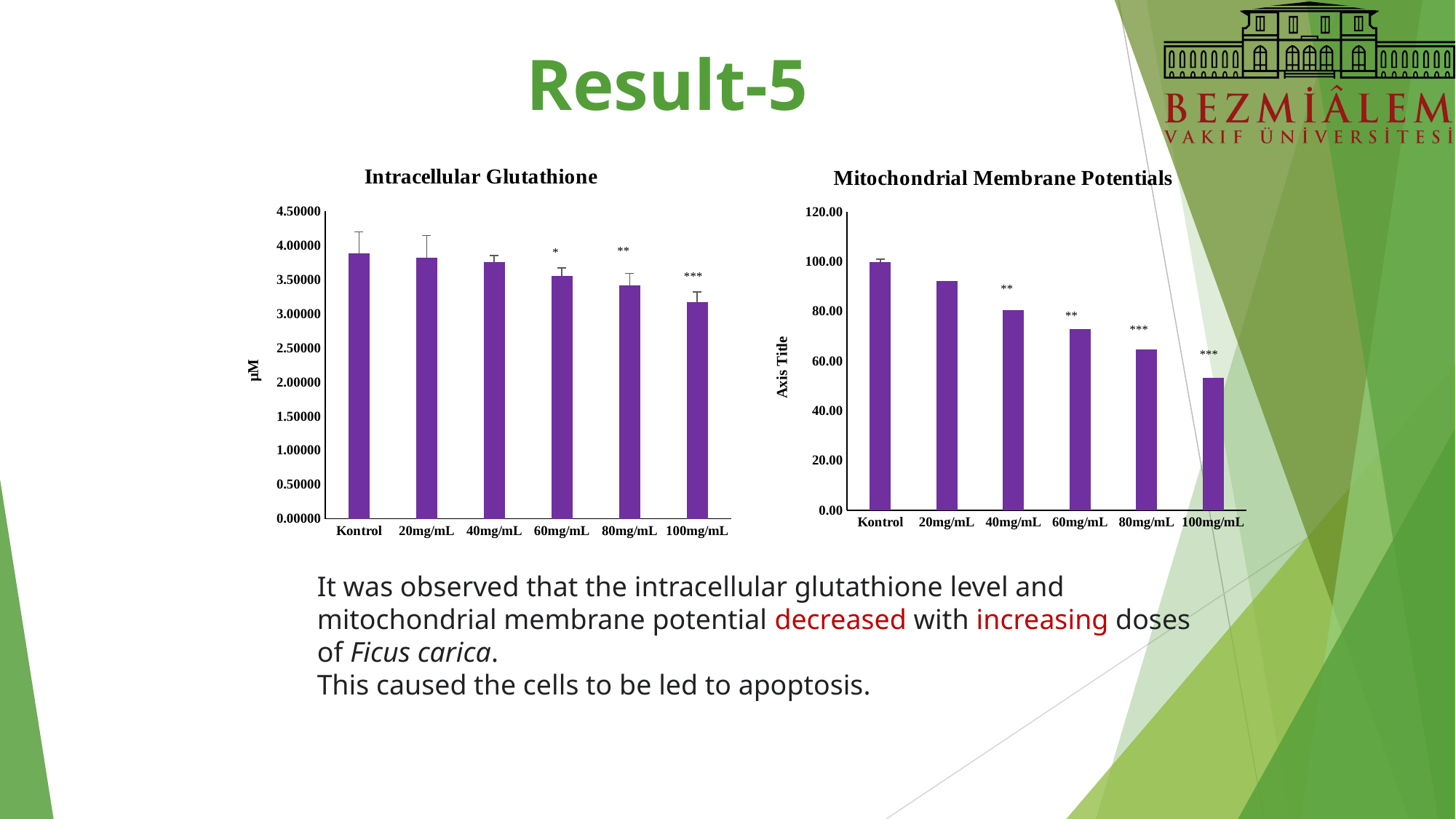
In the Mitochondrial Membrane Potentials chart, is the value for 100mg/mL greater or less than 60.00? less What is the y-axis title of the Intracellular Glutathione chart? µM How many categories are shown on the x axis of the Mitochondrial Membrane Potentials chart? 6 In the Mitochondrial Membrane Potentials chart, which category has the highest value? Kontrol In the Intracellular Glutathione chart, is the value for Kontrol greater or less than 3.50000? greater In the Intracellular Glutathione chart, which category has the lowest value? 100mg/mL In the Intracellular Glutathione chart, is the value for 100mg/mL greater or less than 3.50000? less In the Mitochondrial Membrane Potentials chart, which is larger, the value for 40mg/mL or the value for 100mg/mL? 40mg/mL In the Intracellular Glutathione chart, do the values rise or fall as the dose increases along the x axis? fall What kind of chart is the Intracellular Glutathione chart? bar chart In the Mitochondrial Membrane Potentials chart, which category has the lowest value? 100mg/mL